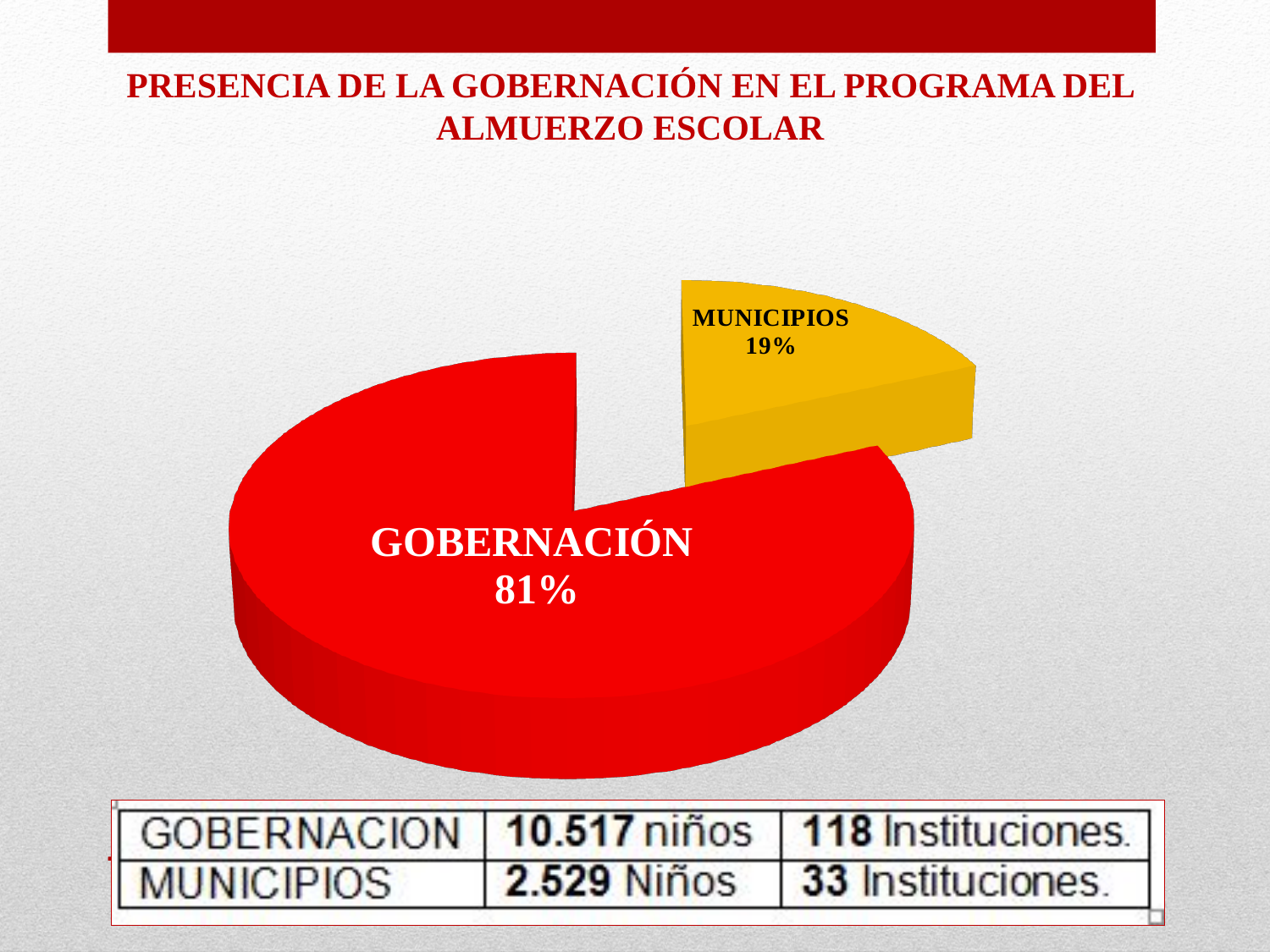
According to the table below the chart, how many Instituciones do MUNICIPIOS cover? 33 Instituciones What kind of chart is shown on the slide? Pie chart What share of the pie does MUNICIPIOS hold? 19% What share of the pie does GOBERNACIÓN hold? 81% According to the table below the chart, how many niños does GOBERNACION cover? 10.517 niños Which slice of the pie is the largest? GOBERNACIÓN What is the title of the chart on the slide? PRESENCIA DE LA GOBERNACIÓN EN EL PROGRAMA DEL ALMUERZO ESCOLAR How many slices does the pie chart have? 2 Which is larger, the GOBERNACIÓN slice or the MUNICIPIOS slice? GOBERNACIÓN What colour is the MUNICIPIOS slice of the pie? Yellow Which slice of the pie is the smallest? MUNICIPIOS What is the difference in percentage points between the GOBERNACIÓN and MUNICIPIOS slices? 62